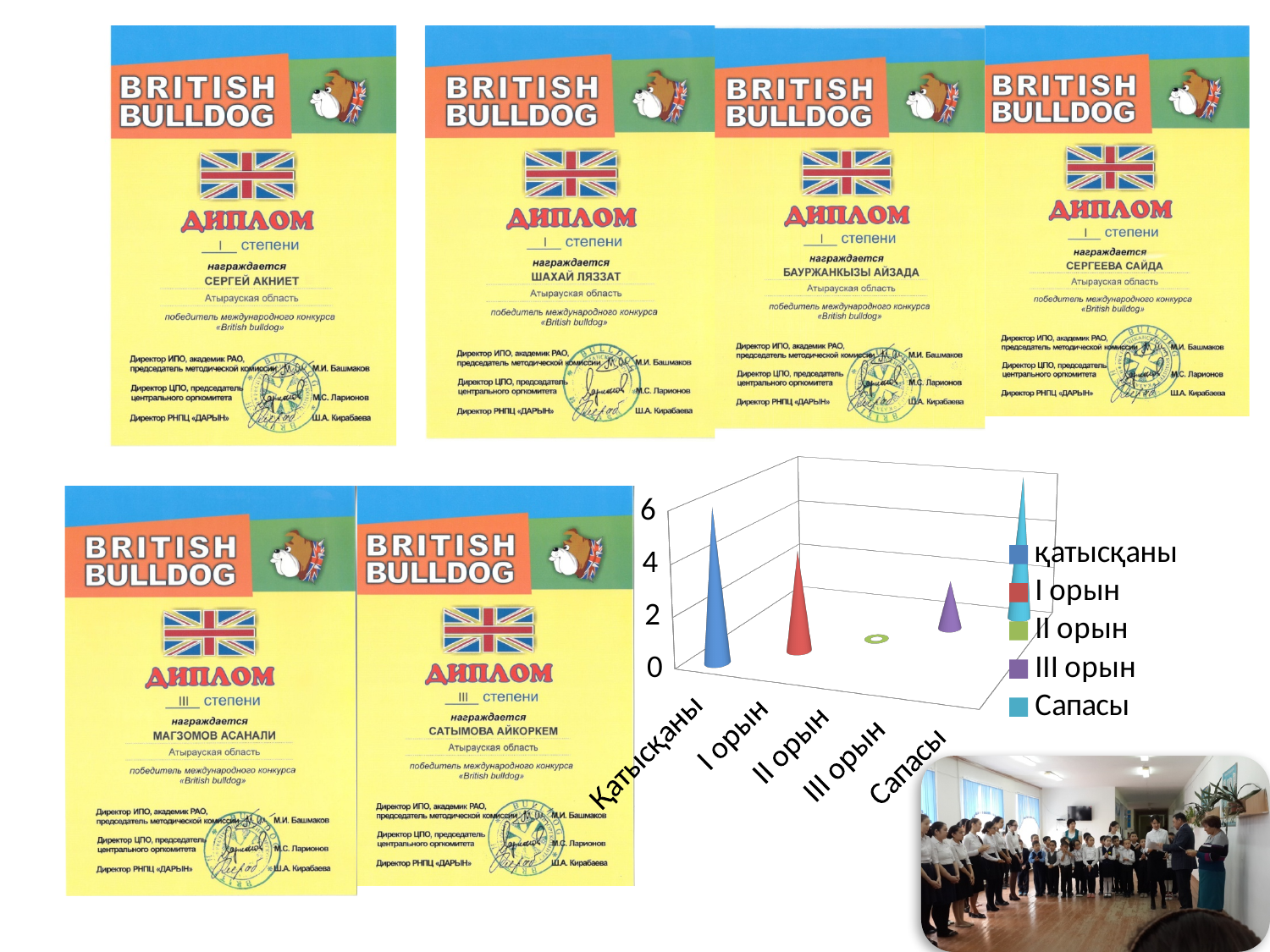
Which is larger, the value for I орын or the value for II орын? I орын Is the value for Сапасы greater or less than 4? greater Which category has the lowest value in the chart? II орын Which legend entry is shown in red? I орын Is the value for III орын greater or less than 4? less Is the value for II орын greater or less than 2? less Which is larger, the value for Қатысқаны or the value for III орын? Қатысқаны How many entries does the chart's legend list? 5 What is the highest tick value shown on the chart's vertical axis? 6 How many categories are shown on the x axis of the chart? 5 What kind of chart is shown on the slide? bar chart